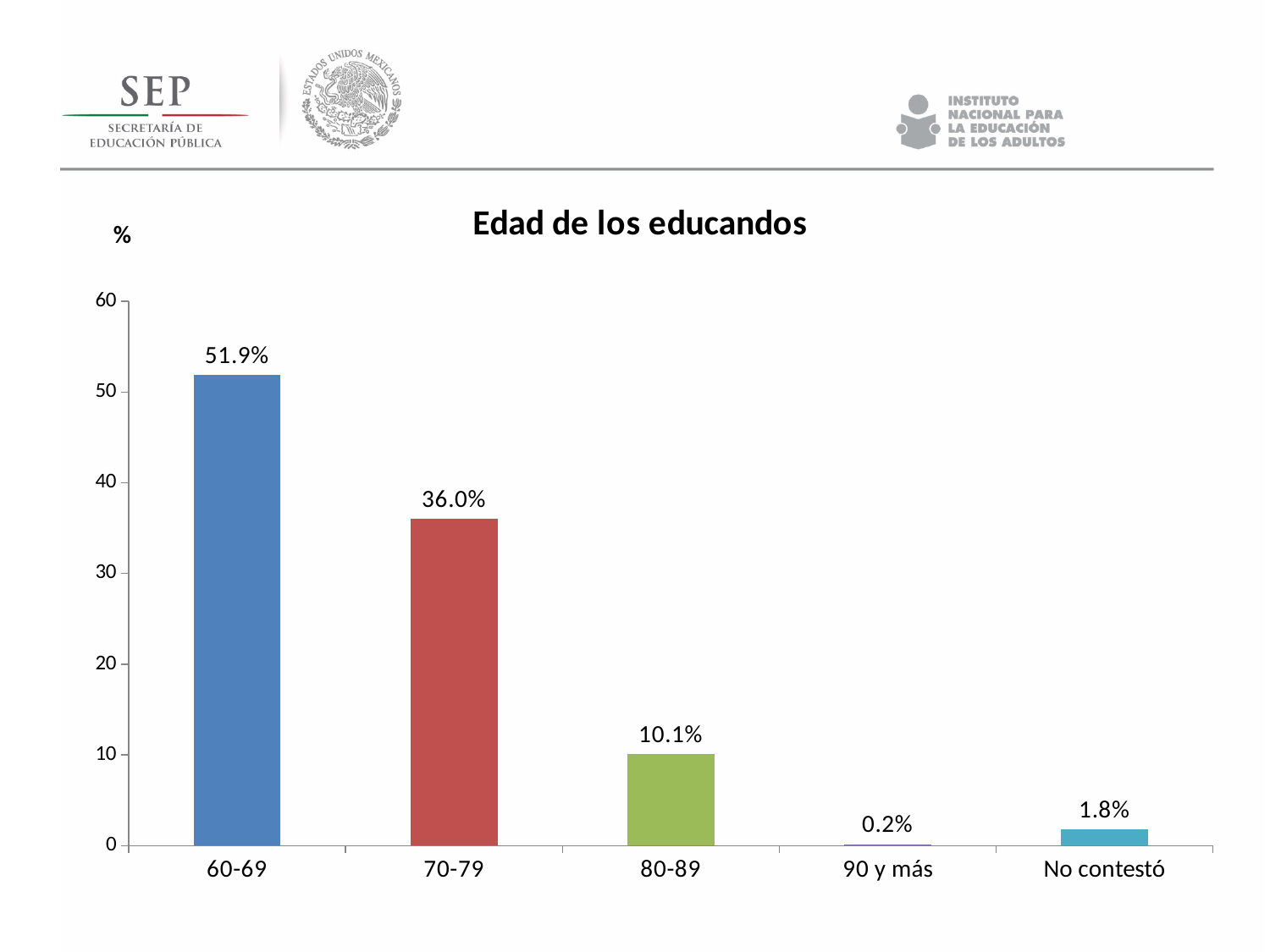
What kind of chart is shown on the slide? Bar chart Which category has the highest value? 60-69 How many categories are shown on the x axis? 5 Which category has the lowest value? 90 y más What is the value for the '90 y más' category? 0.2% What is the title of the chart? Edad de los educandos What is the value for the 'No contestó' category? 1.8% What is the difference between the values for 60-69 and 70-79? 15.9% What is the value for the 70-79 age group? 36.0% What is the value for the 60-69 age group? 51.9% What is the value for the 80-89 age group? 10.1% Which is larger, the value for 80-89 or the value for 'No contestó'? 80-89